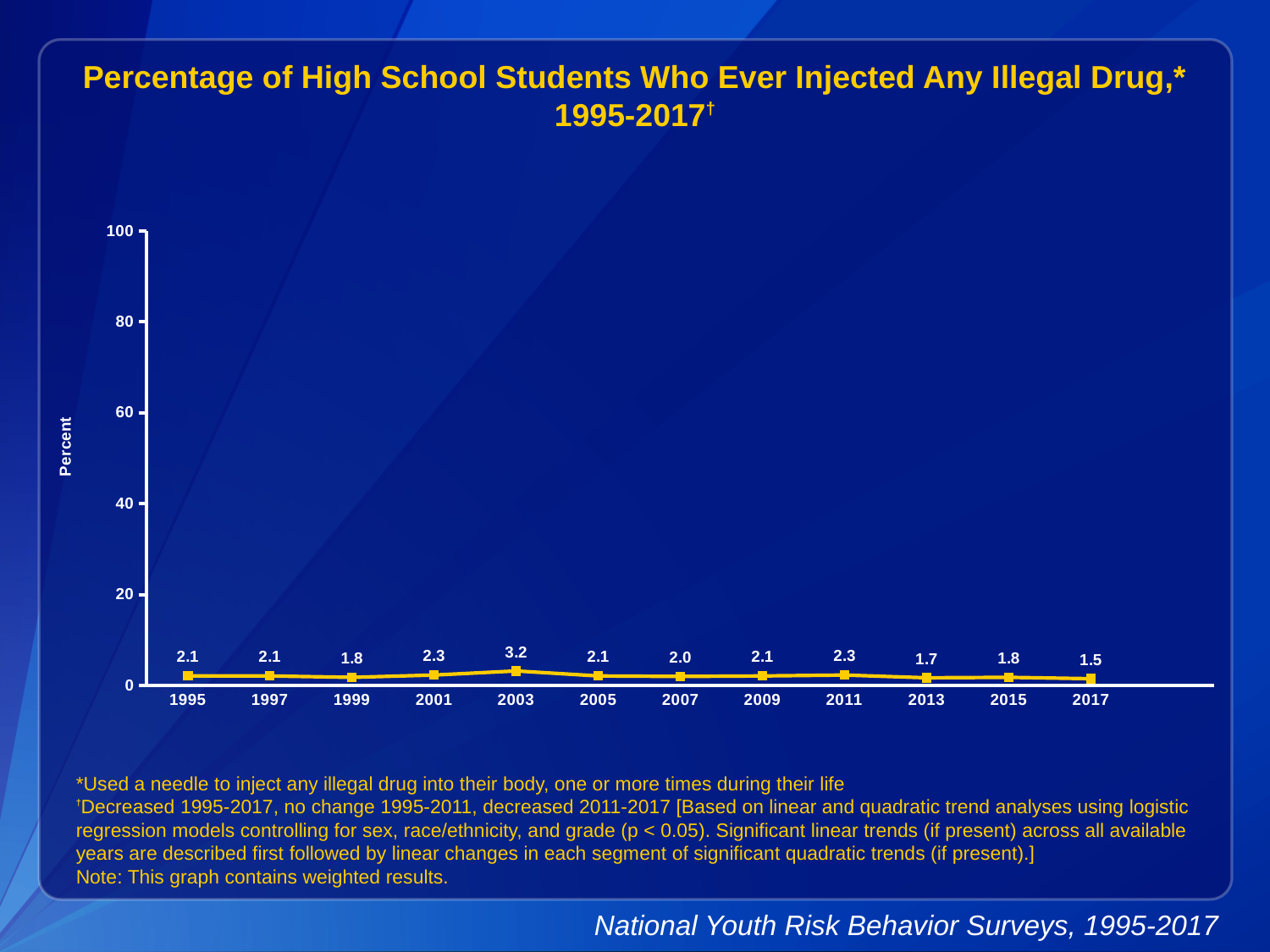
What is the label on the y axis? Percent Do the values rise or fall from 2011 to 2017? fall What kind of chart is shown? line chart How many years are plotted on the chart? 12 Which year has the highest value? 2003 What is the value for 1995? 2.1 What is the value for 2003? 3.2 Which year has the lowest value? 2017 What is the difference between the values for 2003 and 2017? 1.7 Is the value for 2003 greater or less than 20? less What is the value for 2017? 1.5 Which is larger, the value for 2001 or the value for 1999? 2001